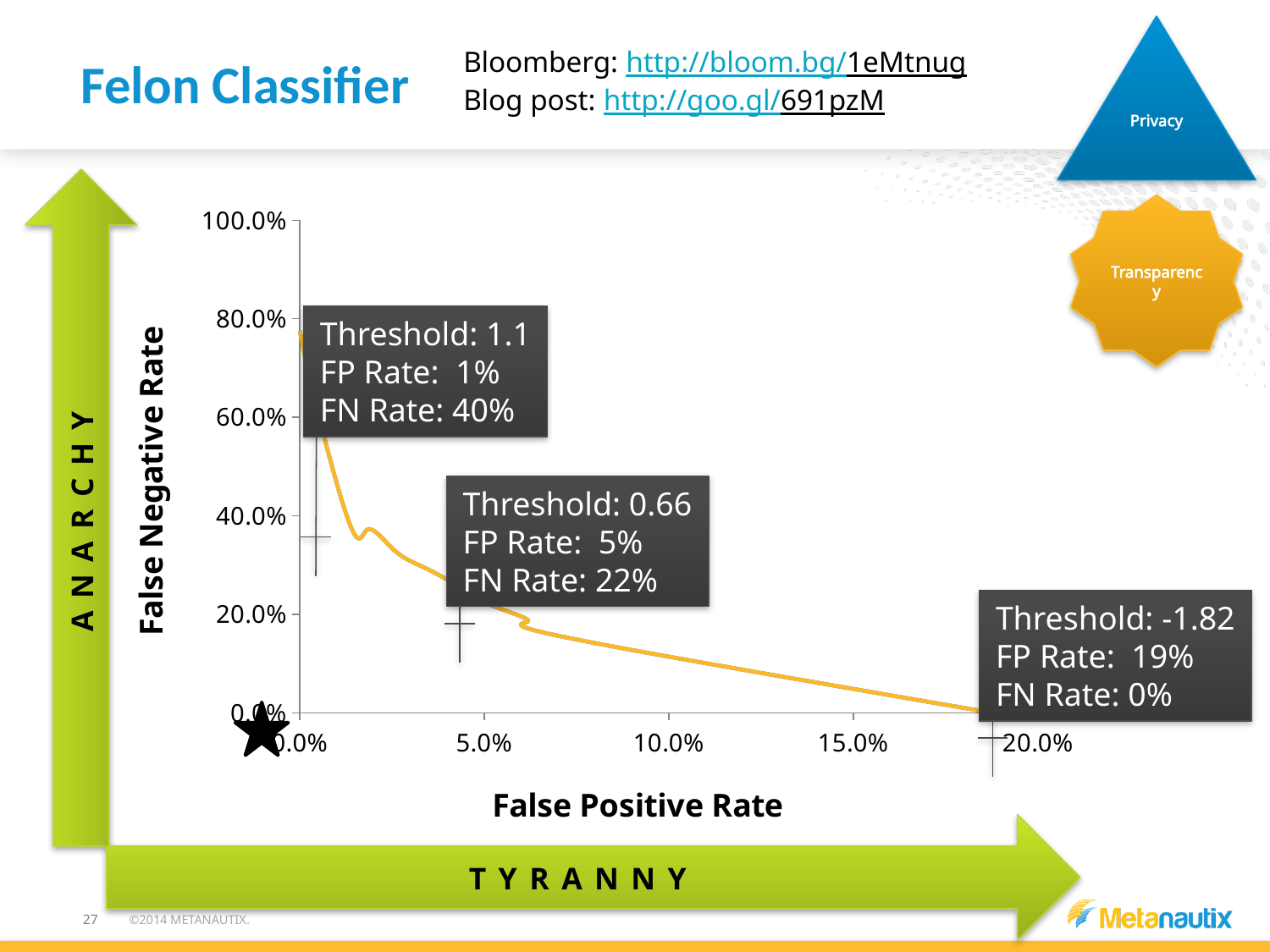
What is the label of the y axis of the chart? False Negative Rate What is the difference in FN Rate between Threshold 1.1 and Threshold 0.66? 18% What is the FN Rate at Threshold 0.66? 22% What is the FP Rate at Threshold -1.82? 19% What is the FN Rate at Threshold -1.82? 0% What kind of chart is shown on the slide? line chart What is the FP Rate at Threshold 0.66? 5% Does the False Negative Rate rise or fall as the False Positive Rate increases along the x axis? fall What is the label of the x axis of the chart? False Positive Rate What is the FP Rate at Threshold 1.1? 1% What is the FN Rate at Threshold 1.1? 40% How many threshold annotations are marked on the chart? 3